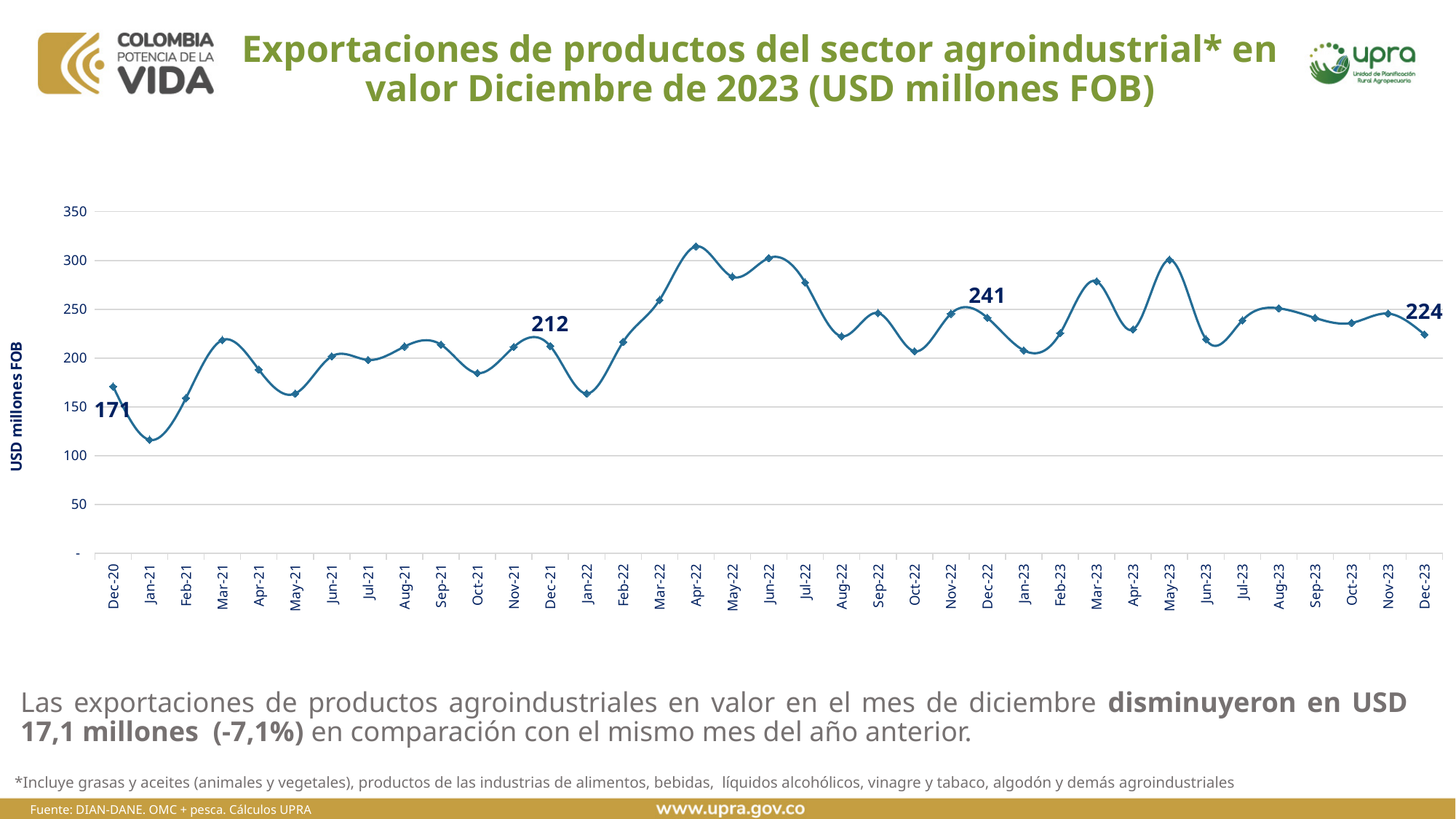
Is the value for Jan-21 greater or less than 150? less What kind of chart is shown on the slide? line chart What is the value for Dec-21? 212 Which is larger, the value for Dec-22 or the value for Dec-23? Dec-22 What is the difference between the values for Dec-22 and Dec-23? 17 What is the value for Dec-20? 171 Is the value for Apr-22 greater or less than 300? greater What is the value for Dec-22? 241 What is the value for Dec-23? 224 Which month has the lowest value on the chart? Jan-21 Which month has the highest value on the chart? Apr-22 What is the difference between the values for Dec-21 and Dec-20? 41